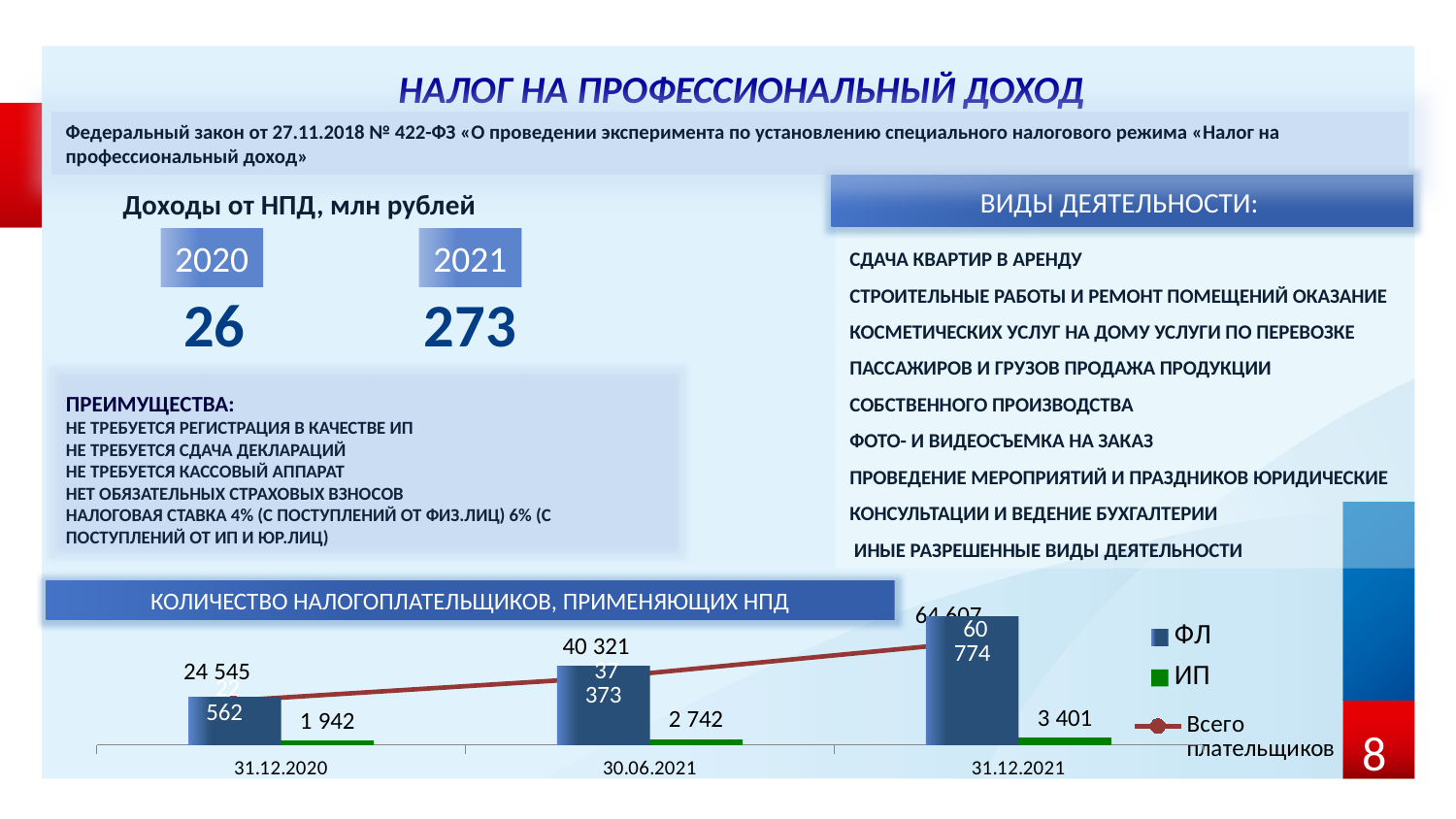
In the chart «КОЛИЧЕСТВО НАЛОГОПЛАТЕЛЬЩИКОВ, ПРИМЕНЯЮЩИХ НПД», on which date is «Всего плательщиков» lowest? 31.12.2020 In the chart «КОЛИЧЕСТВО НАЛОГОПЛАТЕЛЬЩИКОВ, ПРИМЕНЯЮЩИХ НПД», what is the value for ИП on 30.06.2021? 2 742 In the chart «КОЛИЧЕСТВО НАЛОГОПЛАТЕЛЬЩИКОВ, ПРИМЕНЯЮЩИХ НПД», does the «Всего плательщиков» line rise or fall from 31.12.2020 to 31.12.2021? rise In the chart «КОЛИЧЕСТВО НАЛОГОПЛАТЕЛЬЩИКОВ, ПРИМЕНЯЮЩИХ НПД», which is larger on 30.06.2021: ФЛ or ИП? ФЛ In the chart «КОЛИЧЕСТВО НАЛОГОПЛАТЕЛЬЩИКОВ, ПРИМЕНЯЮЩИХ НПД», what is the value for ФЛ on 31.12.2021? 60 774 How many dates are shown on the x axis of the chart «КОЛИЧЕСТВО НАЛОГОПЛАТЕЛЬЩИКОВ, ПРИМЕНЯЮЩИХ НПД»? 3 How many series does the legend of the chart «КОЛИЧЕСТВО НАЛОГОПЛАТЕЛЬЩИКОВ, ПРИМЕНЯЮЩИХ НПД» list? 3 In the chart «КОЛИЧЕСТВО НАЛОГОПЛАТЕЛЬЩИКОВ, ПРИМЕНЯЮЩИХ НПД», by how much did the ИП value increase from 31.12.2020 to 31.12.2021? 1 459 In the chart «КОЛИЧЕСТВО НАЛОГОПЛАТЕЛЬЩИКОВ, ПРИМЕНЯЮЩИХ НПД», on which date is the ИП value highest? 31.12.2021 In the chart «КОЛИЧЕСТВО НАЛОГОПЛАТЕЛЬЩИКОВ, ПРИМЕНЯЮЩИХ НПД», what is the value for ИП on 31.12.2021? 3 401 What kind of chart is shown under the title «КОЛИЧЕСТВО НАЛОГОПЛАТЕЛЬЩИКОВ, ПРИМЕНЯЮЩИХ НПД»? bar chart with a line In the chart «КОЛИЧЕСТВО НАЛОГОПЛАТЕЛЬЩИКОВ, ПРИМЕНЯЮЩИХ НПД», what is the value of «Всего плательщиков» on 30.06.2021? 40 321